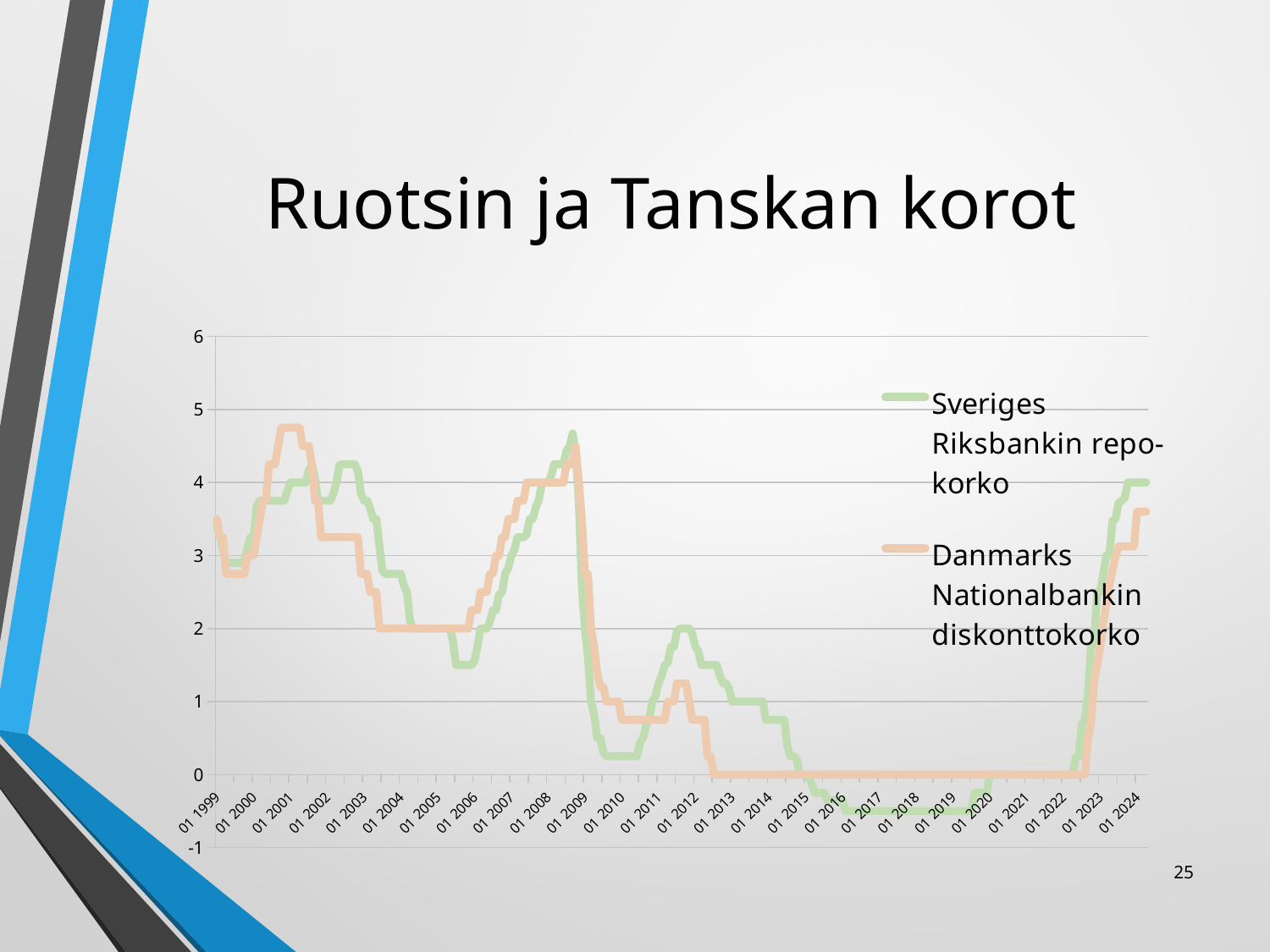
Is the value of Danmarks Nationalbankin diskonttokorko at 01 2010 greater or less than 1? less What is the title of the slide containing the chart? Ruotsin ja Tanskan korot Do the values of Sveriges Riksbankin repo-korko rise or fall between 01 2022 and 01 2024? rise Which series is drawn in green? Sveriges Riksbankin repo-korko How many series does the legend list? 2 Do the values of Danmarks Nationalbankin diskonttokorko rise or fall between 01 2008 and 01 2010? fall Is the value of Sveriges Riksbankin repo-korko at 01 2017 greater or less than 0? less Is the value of Danmarks Nationalbankin diskonttokorko at 01 2024 greater or less than 3? greater At 01 2003, which series has the higher value, Sveriges Riksbankin repo-korko or Danmarks Nationalbankin diskonttokorko? Sveriges Riksbankin repo-korko What kind of chart is shown on the slide? line chart At 01 2001, which series has the higher value, Sveriges Riksbankin repo-korko or Danmarks Nationalbankin diskonttokorko? Danmarks Nationalbankin diskonttokorko